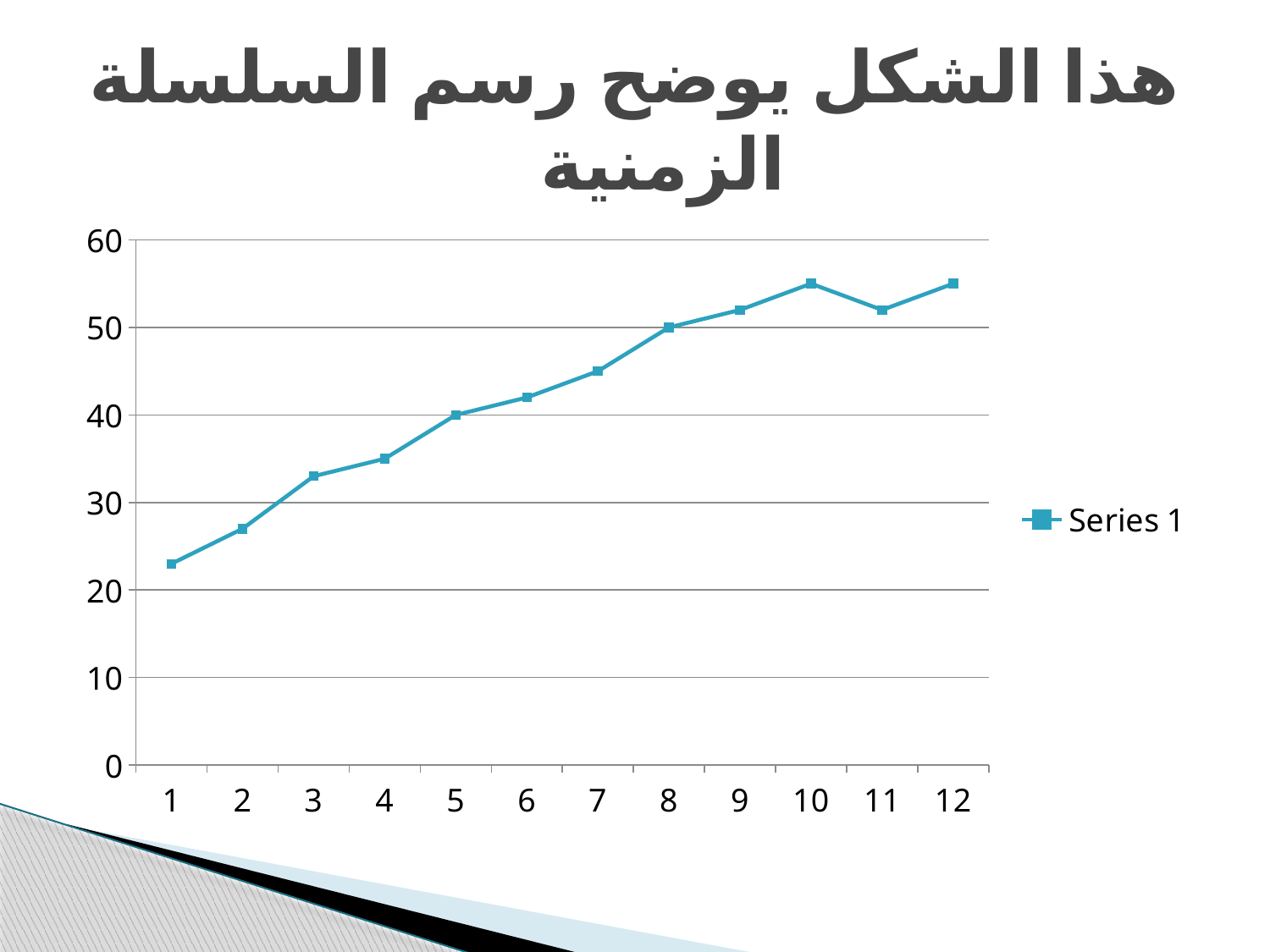
How many data points are plotted along the x axis? 12 Is the value at point 3 greater or less than 30? greater Is the value at point 10 greater or less than 50? greater What kind of chart is shown on the slide? line chart Which is larger, the value at point 2 or the value at point 7? point 7 What is the name of the series shown in the legend? Series 1 Is the value at point 1 greater or less than 30? less How many series does the legend list? 1 Do the values generally rise or fall from point 1 to point 12? rise What is the value at point 8? 50 Which x-axis point has the lowest value? 1 What is the value at point 5? 40